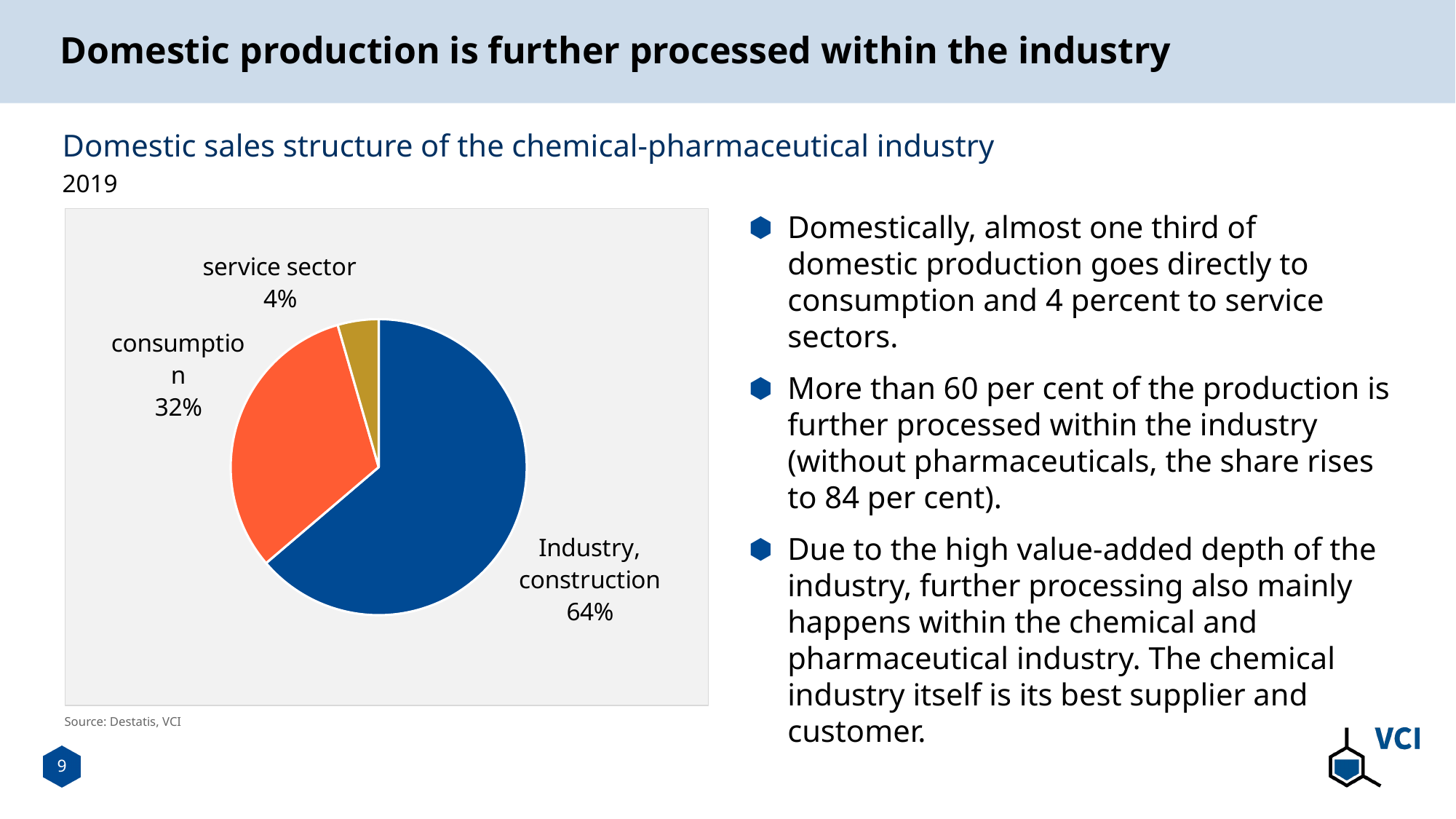
What share of domestic sales goes to the service sector? 4% Which is larger, the share for consumption or the share for the service sector? consumption What share of domestic sales goes to consumption? 32% How many percentage points larger is the Industry, construction share than the consumption share? 32 What kind of chart is shown on the slide? pie chart What share of domestic sales goes to Industry, construction? 64% How many slices does the pie chart have? 3 What is the title of the chart? Domestic sales structure of the chemical-pharmaceutical industry Which category has the largest share of the pie? Industry, construction How many percentage points larger is the consumption share than the service sector share? 28 What year does the chart refer to? 2019 Which category has the smallest share of the pie? service sector